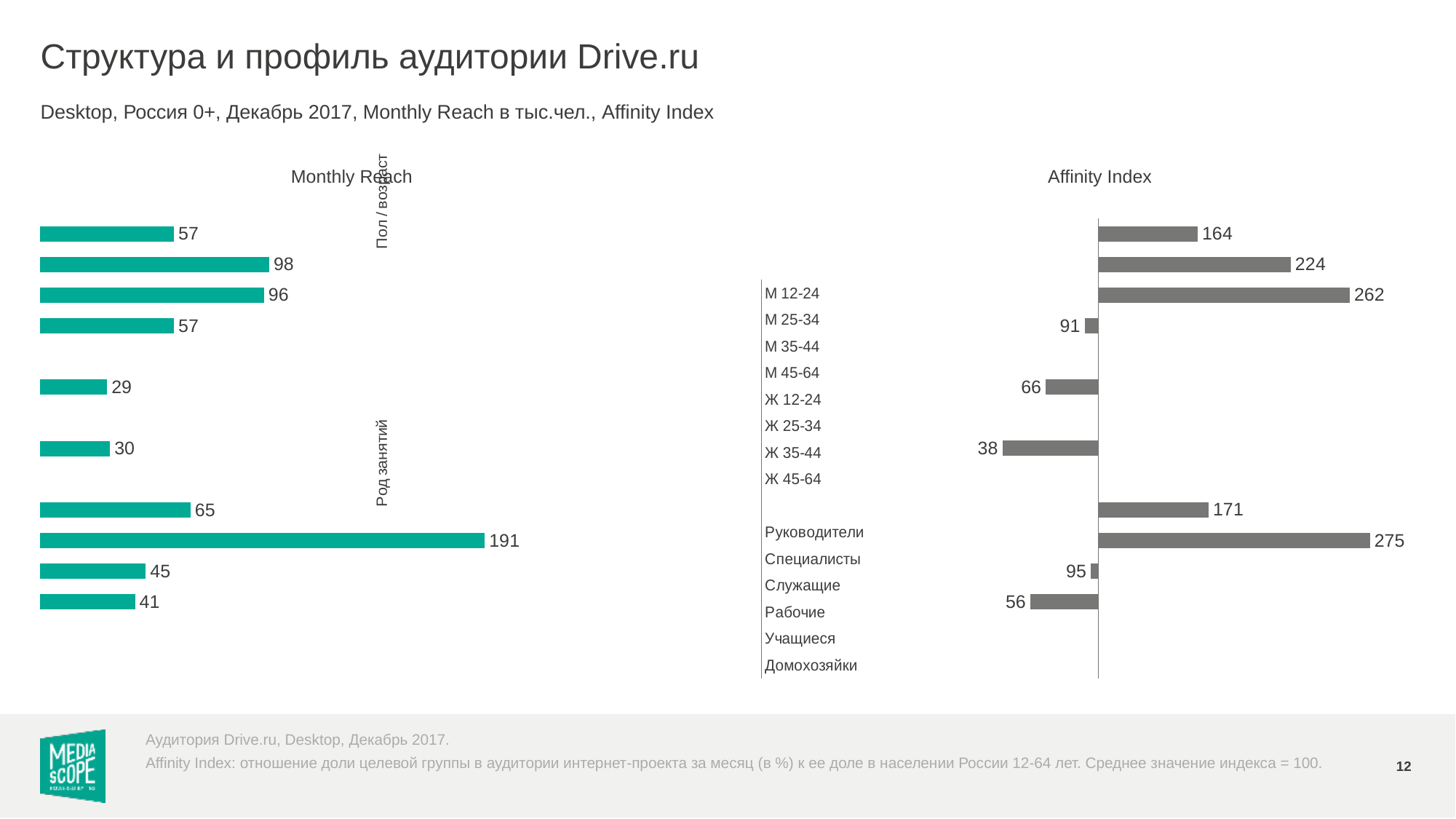
What kind of chart is the Affinity Index chart on the right? bar chart In the Monthly Reach chart, what is the lowest value shown? 29 In the Monthly Reach chart, what is the difference between the highest value (191) and the lowest value (29)? 162 In the Affinity Index chart, what is the lowest value shown? 38 In the Affinity Index chart, which is larger: the topmost bar (164) or the second bar from the top (224)? 224 What kind of chart is the Monthly Reach chart on the left? bar chart In the Monthly Reach chart, what is the value of the topmost bar? 57 In the Affinity Index chart, what is the value of the bottom bar? 56 In the Affinity Index chart, what is the highest value shown? 275 What is the title of the chart on the right side of the slide? Affinity Index How many labelled bars are plotted in the Monthly Reach chart? 10 In the Monthly Reach chart, what is the highest value shown? 191